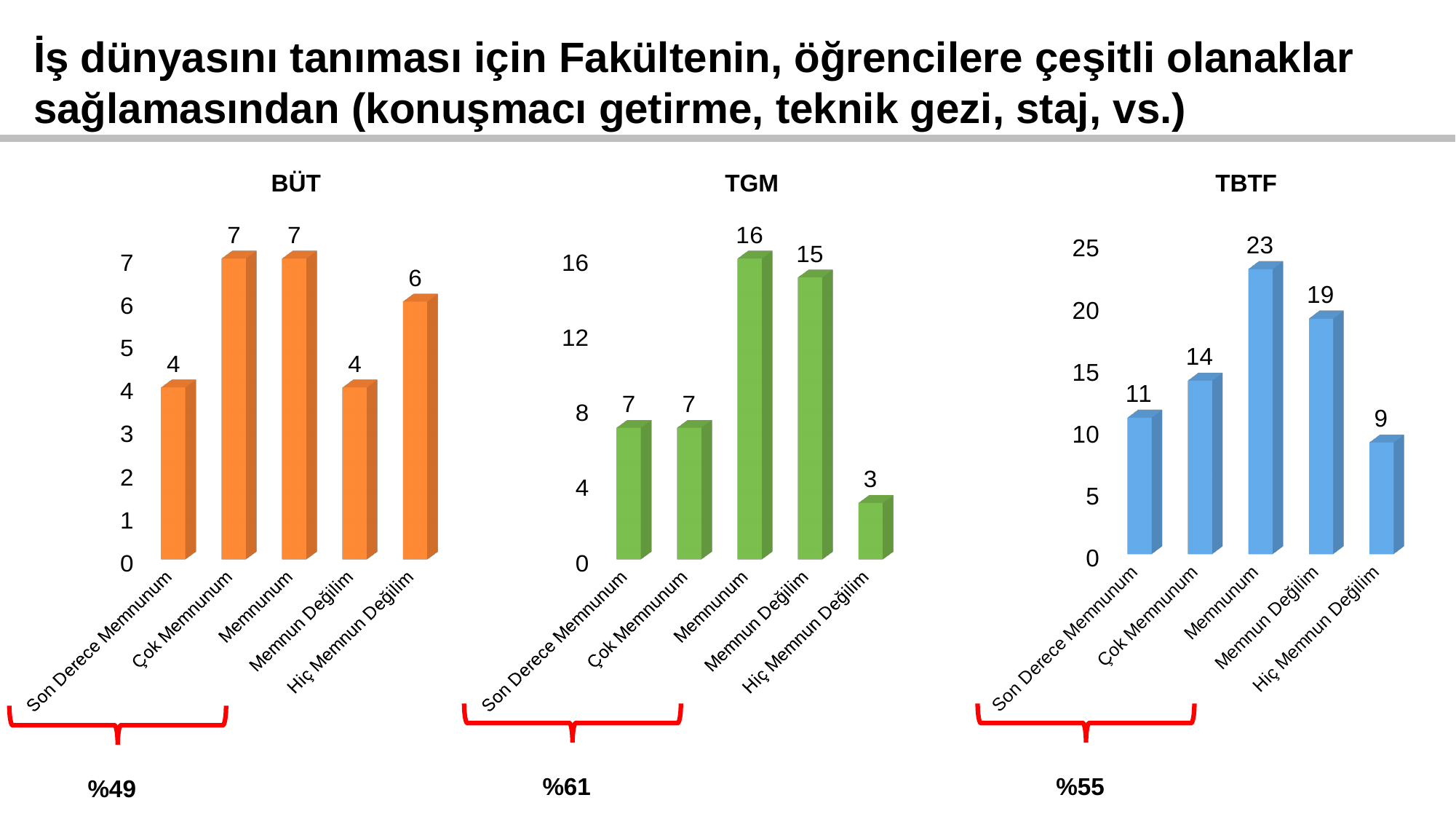
In the TBTF chart, what is the difference between the values for Memnunum and Hiç Memnun Değilim? 14 In the BÜT chart, which is larger: the value for Hiç Memnun Değilim or the value for Memnun Değilim? Hiç Memnun Değilim How many categories are shown in the TGM chart? 5 In the TGM chart, which category has the lowest value? Hiç Memnun Değilim What kind of chart is the BÜT chart? bar chart In the TBTF chart, what is the value for Çok Memnunum? 14 In the BÜT chart, what is the value for Hiç Memnun Değilim? 6 What is the title of the chart on the right of the slide? TBTF In the TBTF chart, is the value for Memnun Değilim greater or less than 15? greater In the TGM chart, what is the value for Memnunum? 16 In the TGM chart, what is the difference between the values for Memnun Değilim and Son Derece Memnunum? 8 In the TBTF chart, which category has the highest value? Memnunum